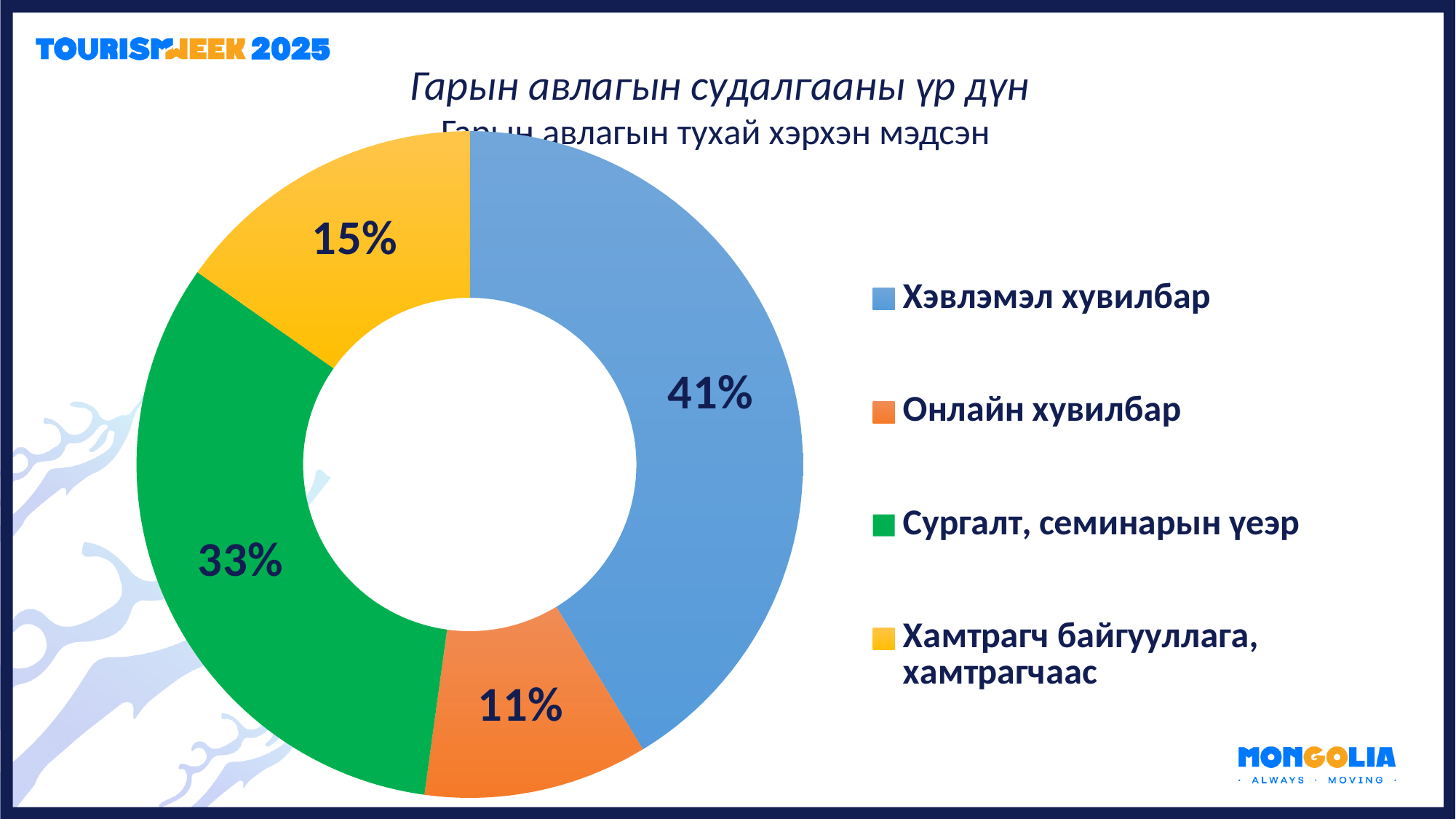
Which category has the smallest share of the chart? Онлайн хувилбар What percentage is shown for Хамтрагч байгууллага, хамтрагчаас? 15% Which is larger, the share for Хамтрагч байгууллага, хамтрагчаас or the share for Онлайн хувилбар? Хамтрагч байгууллага, хамтрагчаас What percentage is shown for Сургалт, семинарын үеэр? 33% What is the title of the chart? Гарын авлагын тухай хэрхэн мэдсэн What percentage is shown for Онлайн хувилбар? 11% What colour represents Сургалт, семинарын үеэр in the chart? Green What is the difference in percentage points between Хэвлэмэл хувилбар and Сургалт, семинарын үеэр? 8 Which category has the largest share of the chart? Хэвлэмэл хувилбар How many categories does the chart show? 4 What kind of chart is shown on the slide? Doughnut (pie) chart What percentage is shown for Хэвлэмэл хувилбар? 41%